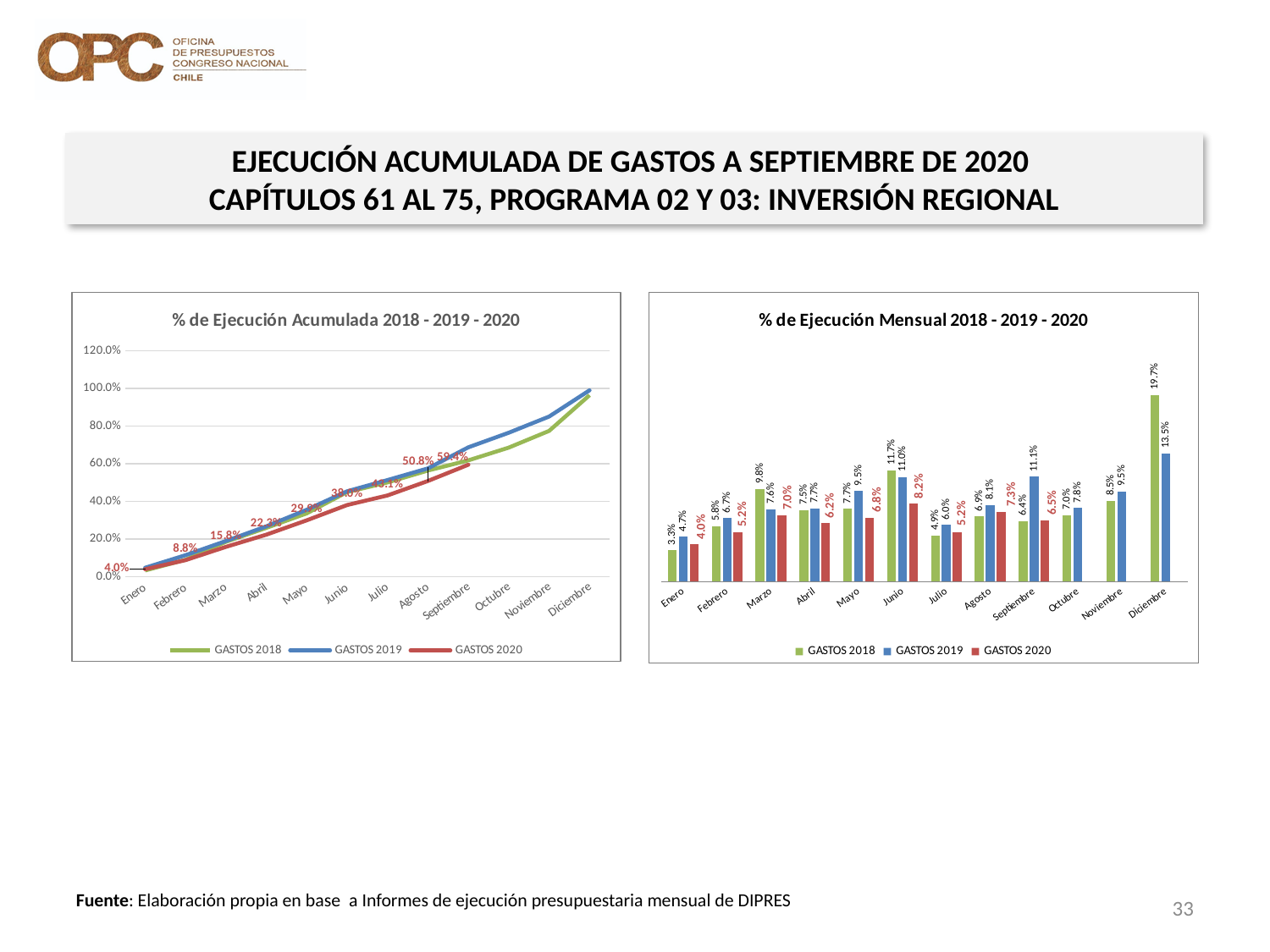
In the '% de Ejecución Mensual' chart on the right, which is larger for Septiembre: GASTOS 2018 or GASTOS 2019? GASTOS 2019 In the '% de Ejecución Mensual' chart on the right, which month has the lowest GASTOS 2018 value? Enero What kind of chart is the '% de Ejecución Mensual 2018 - 2019 - 2020' chart on the right? Bar chart In the '% de Ejecución Mensual' chart on the right, what is the GASTOS 2018 value for Diciembre? 19.7% How many series does the legend of the '% de Ejecución Acumulada' chart on the left list? 3 In the '% de Ejecución Acumulada' chart on the left, what is the GASTOS 2020 value for Enero? 4.0% In the '% de Ejecución Mensual' chart on the right, which month has the highest GASTOS 2020 value? Junio In the '% de Ejecución Acumulada' chart on the left, does the GASTOS 2019 line rise or fall from Enero to Diciembre? Rises In the '% de Ejecución Mensual' chart on the right, what is the difference between the GASTOS 2018 and GASTOS 2019 values for Diciembre? 6.2% What kind of chart is the '% de Ejecución Acumulada 2018 - 2019 - 2020' chart on the left? Line chart In the '% de Ejecución Mensual' chart on the right, what is the GASTOS 2020 value for Junio? 8.2% In the '% de Ejecución Acumulada' chart on the left, what is the GASTOS 2020 value for Agosto? 50.8%